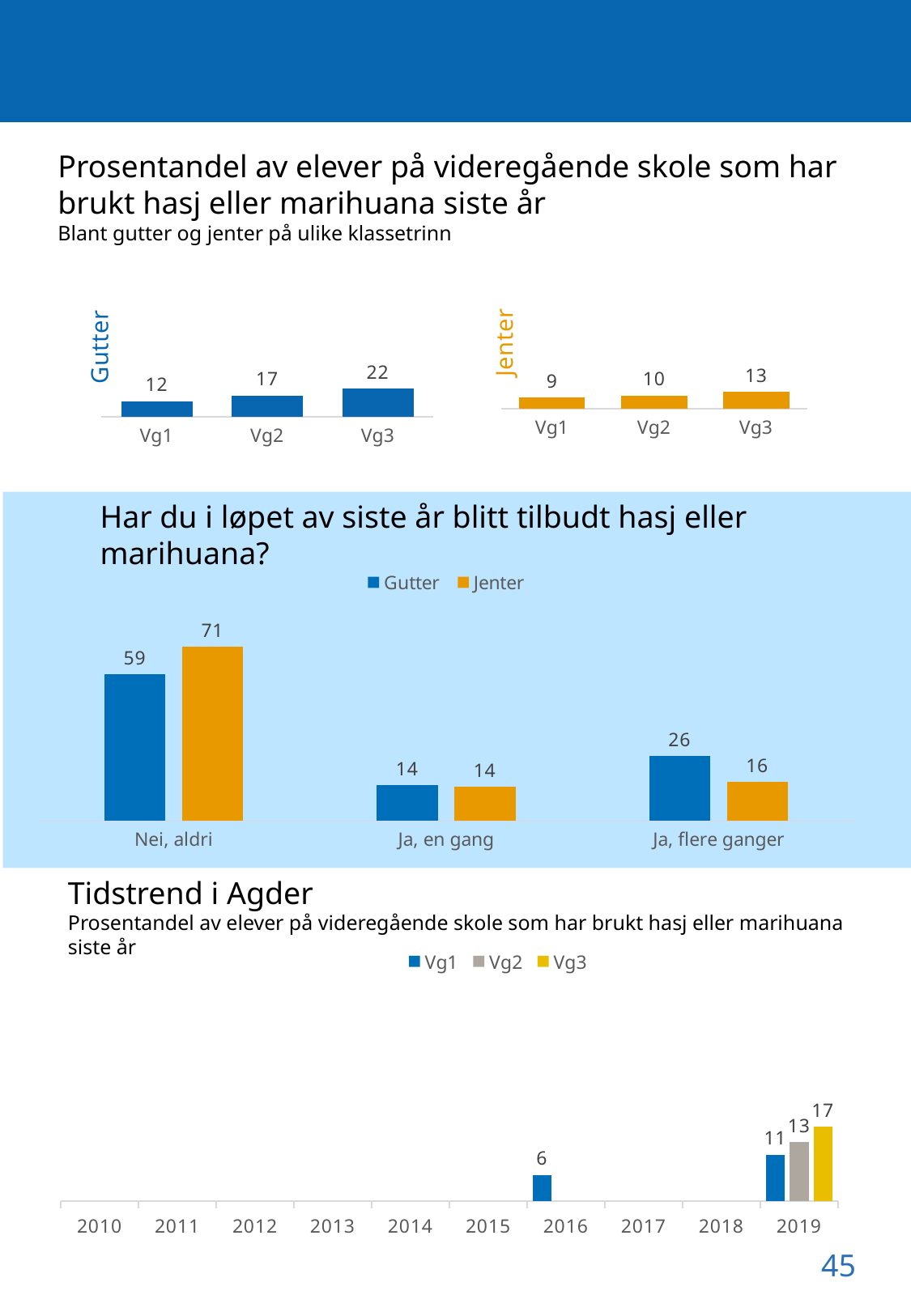
What kind of chart is the 'Tidstrend i Agder' chart? bar chart In the 'Gutter' chart at the top left, what is the difference between the values for Vg3 and Vg1? 10 In the 'Gutter' chart at the top left, what is the value for Vg3? 22 In the chart 'Har du i løpet av siste år blitt tilbudt hasj eller marihuana?', what is the difference between Gutter and Jenter in the 'Ja, flere ganger' category? 10 In the chart 'Har du i løpet av siste år blitt tilbudt hasj eller marihuana?', what is the value for Jenter in the 'Nei, aldri' category? 71 In the 'Tidstrend i Agder' chart, what is the value shown for 2016? 6 In the 'Tidstrend i Agder' chart, what is the value for Vg2 in 2019? 13 In the 'Jenter' chart at the top right, do the values rise or fall from Vg1 to Vg3? rise In the chart 'Har du i løpet av siste år blitt tilbudt hasj eller marihuana?', how many series does the legend list? 2 In the 'Jenter' chart at the top right, which class level has the lowest value? Vg1 In the chart 'Har du i løpet av siste år blitt tilbudt hasj eller marihuana?', which is larger for 'Ja, flere ganger': Gutter or Jenter? Gutter In the chart 'Har du i løpet av siste år blitt tilbudt hasj eller marihuana?', how many categories are shown on the x axis? 3